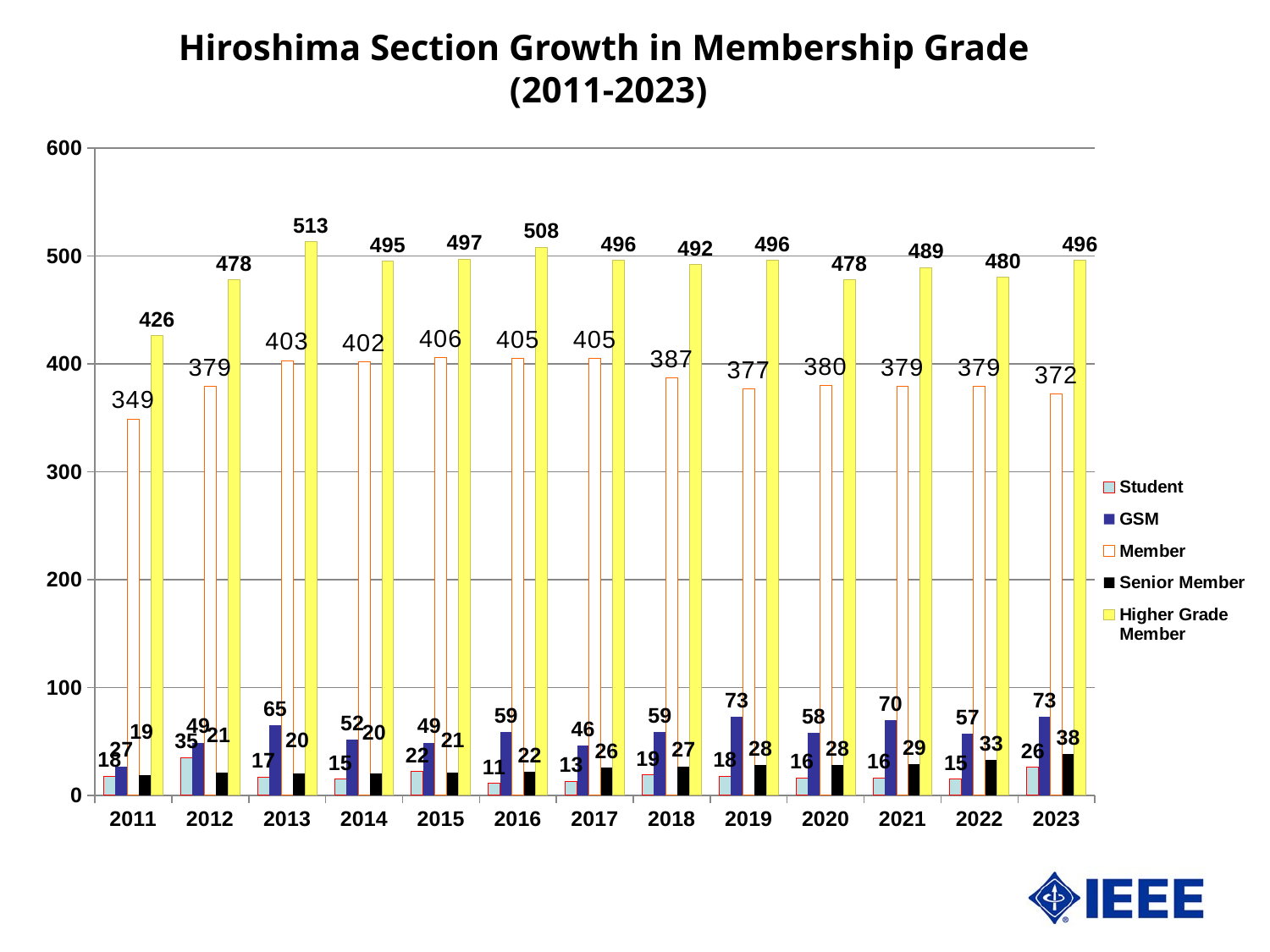
How many series does the legend list? 5 In which year is the Member value lowest? 2011 What is the value for Senior Member in 2023? 38 What is the title of the chart? Hiroshima Section Growth in Membership Grade (2011-2023) What kind of chart is shown on the slide? bar chart What is the value for Member in 2011? 349 In which year is the Higher Grade Member value highest? 2013 What is the value for Higher Grade Member in 2013? 513 Which year has the larger GSM value, 2019 or 2021? 2019 What is the difference between the Higher Grade Member values in 2023 and 2011? 70 In which year is the Senior Member value highest? 2023 How many years are shown on the x axis? 13